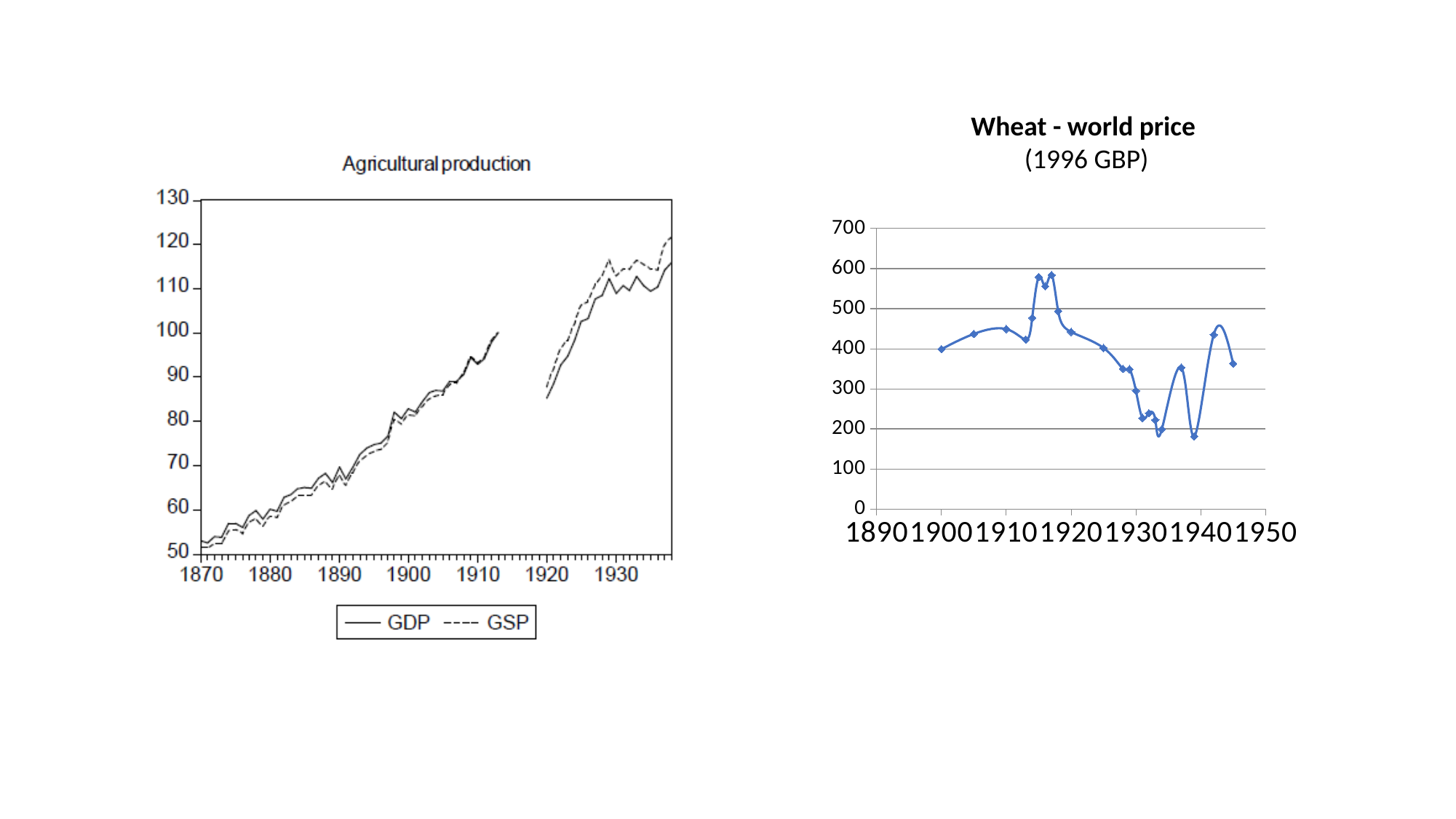
In the 'Wheat - world price' chart, does the price rise or fall between 1920 and 1930? fall In the 'Wheat - world price' chart, is the highest value greater or less than 500? greater What kind of chart is the 'Wheat - world price' chart on the right? line chart In the 'Wheat - world price' chart, is the lowest value greater or less than 200? less What unit is given in the subtitle of the 'Wheat - world price' chart? 1996 GBP In the 'Agricultural production' chart, do the GDP and GSP values generally rise or fall from 1870 to 1910? rise In the 'Wheat - world price' chart, is the value in 1900 greater or less than 500? less In the 'Agricultural production' chart, which series is drawn with a dashed line? GSP What kind of chart is the 'Agricultural production' chart on the left? line chart How many series does the legend of the 'Agricultural production' chart list? 2